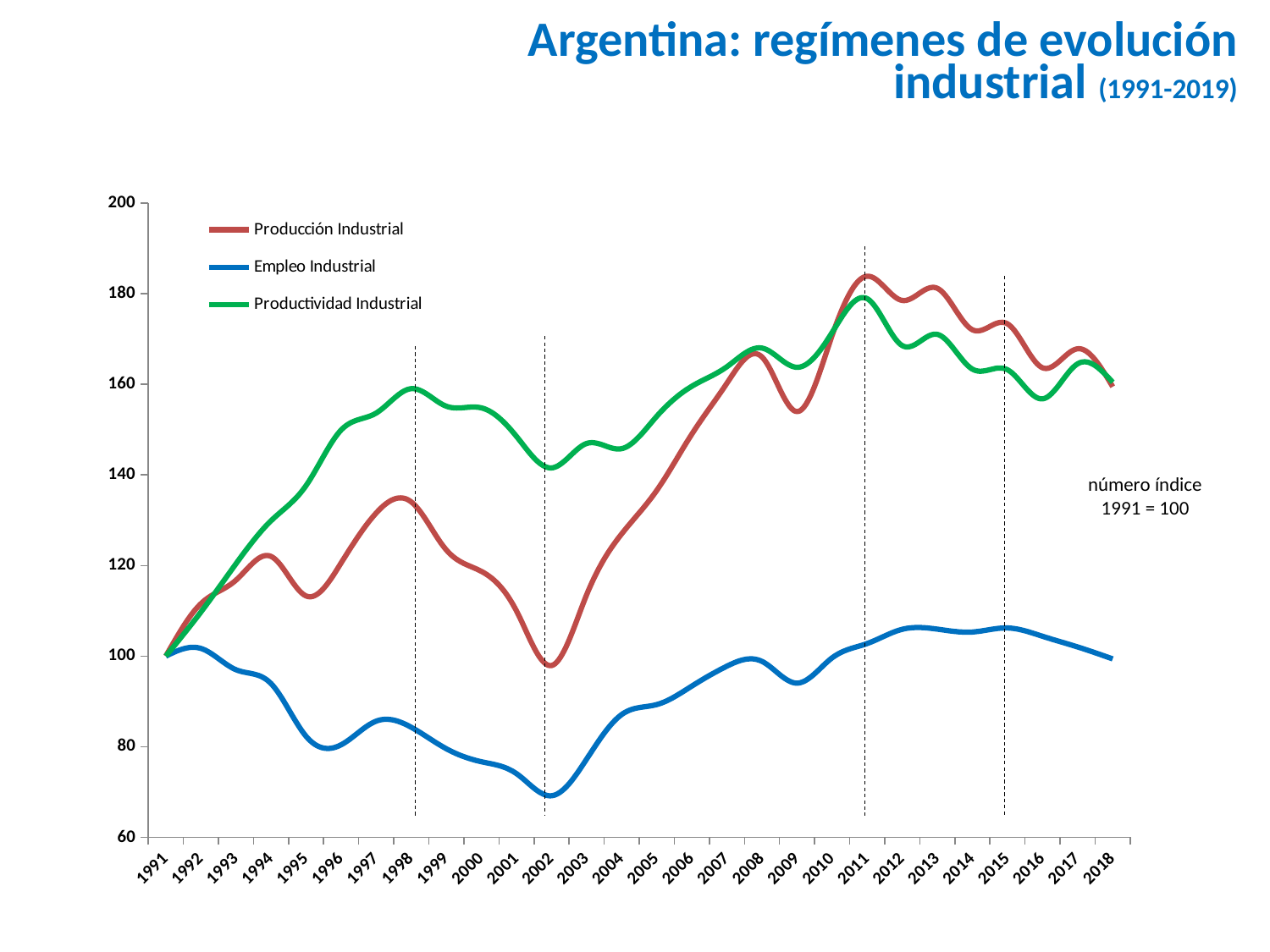
In 2002, which is larger: Productividad Industrial or Empleo Industrial? Productividad Industrial Is the value for Empleo Industrial in 2002 greater or less than 80? less Which series has the lowest value in 2002? Empleo Industrial In which year does Empleo Industrial reach its lowest value? 2002 How many series does the legend list? 3 What kind of chart is shown on the slide? line chart Is the value for Empleo Industrial in 2009 greater or less than 100? less Does Empleo Industrial rise or fall between 1991 and 2002? fall How many years are labelled along the x axis? 28 Is the value for Producción Industrial in 2011 greater or less than 180? greater Which colour is used for the Empleo Industrial line? blue What is the index value of all three series in 1991? 100